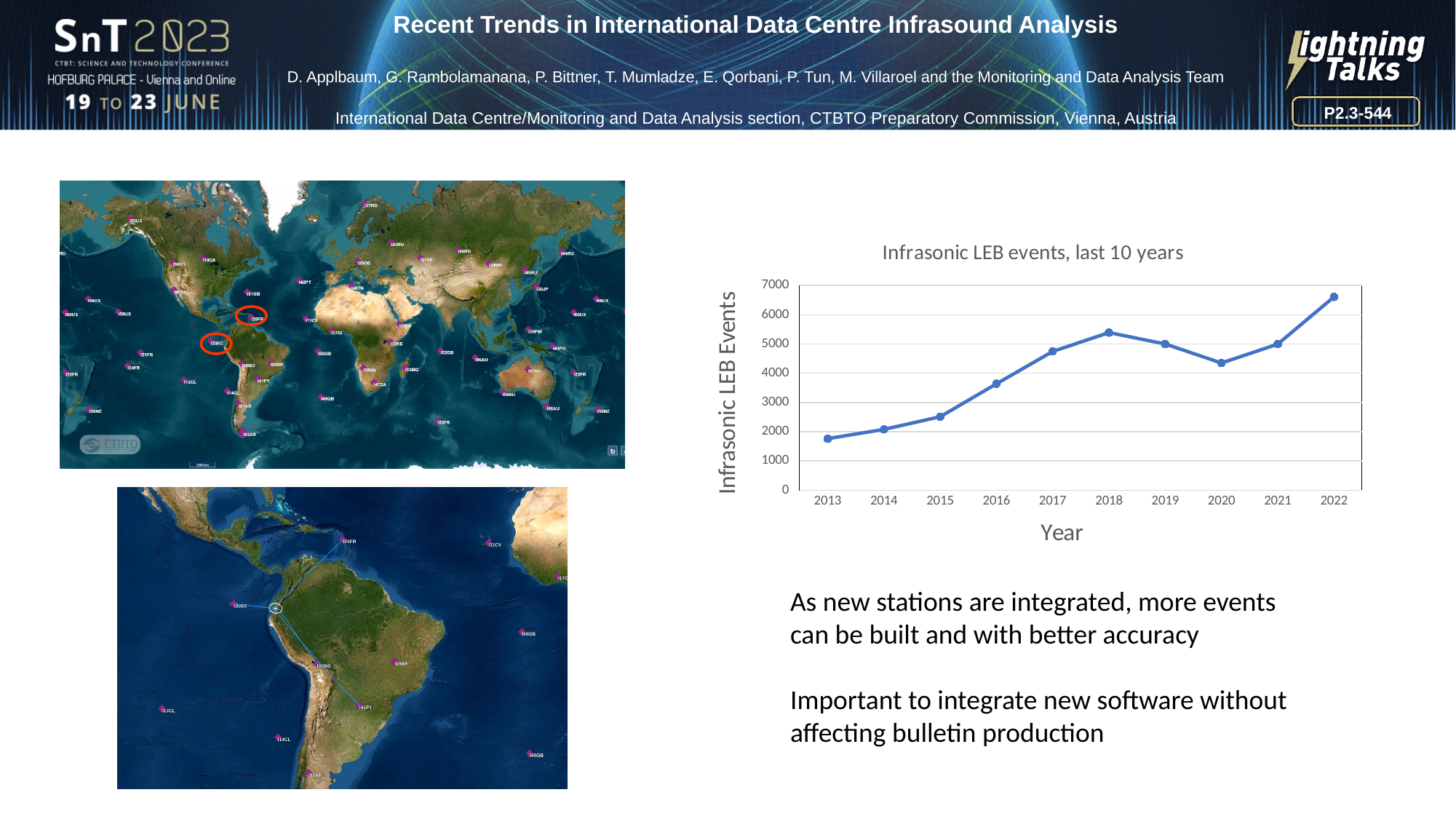
Which year has the highest number of infrasonic LEB events in the chart? 2022 What is the label of the y axis of the line chart? Infrasonic LEB Events How many years are plotted on the x axis of the 'Infrasonic LEB events, last 10 years' chart? 10 Which year has more infrasonic LEB events, 2018 or 2020? 2018 Is the value for 2022 greater or less than 6000? greater Which year has the lowest number of infrasonic LEB events in the chart? 2013 What kind of chart is 'Infrasonic LEB events, last 10 years'? line chart Is the value for 2016 greater or less than 3000? greater What is the title of the line chart on the slide? Infrasonic LEB events, last 10 years Do the infrasonic LEB events rise or fall between 2018 and 2020? fall Is the value for 2020 greater or less than 5000? less